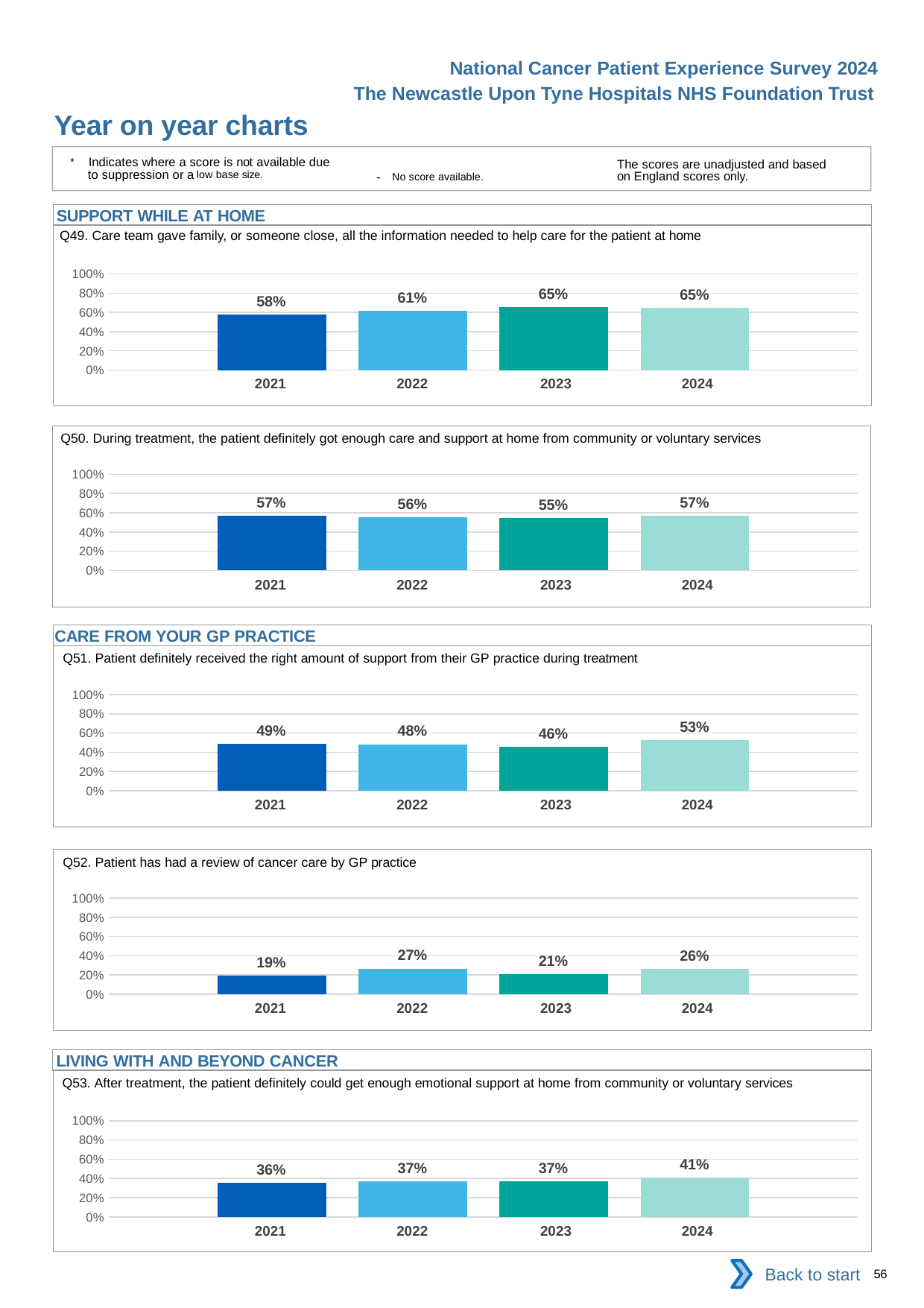
In the Q53 chart, how many years are plotted? 4 In the Q50 chart, what is the difference between the 2021 and 2023 values? 2% In the Q49 chart, what is the value for 2022? 61% What kind of chart is the Q53 chart? Bar chart In the Q51 chart, which year has the highest value? 2024 In the Q50 chart, what is the value for 2024? 57% In the Q52 chart, what is the difference between the 2022 and 2021 values? 8% In the Q51 chart, what is the value for 2023? 46% In the Q49 chart, which year has the lowest value? 2021 In the Q49 chart, do the values rise or fall from 2021 to 2023? Rise In the Q53 chart, is the value for 2024 greater or less than 40%? greater In the Q52 chart, which is larger, the value for 2022 or the value for 2023? 2022